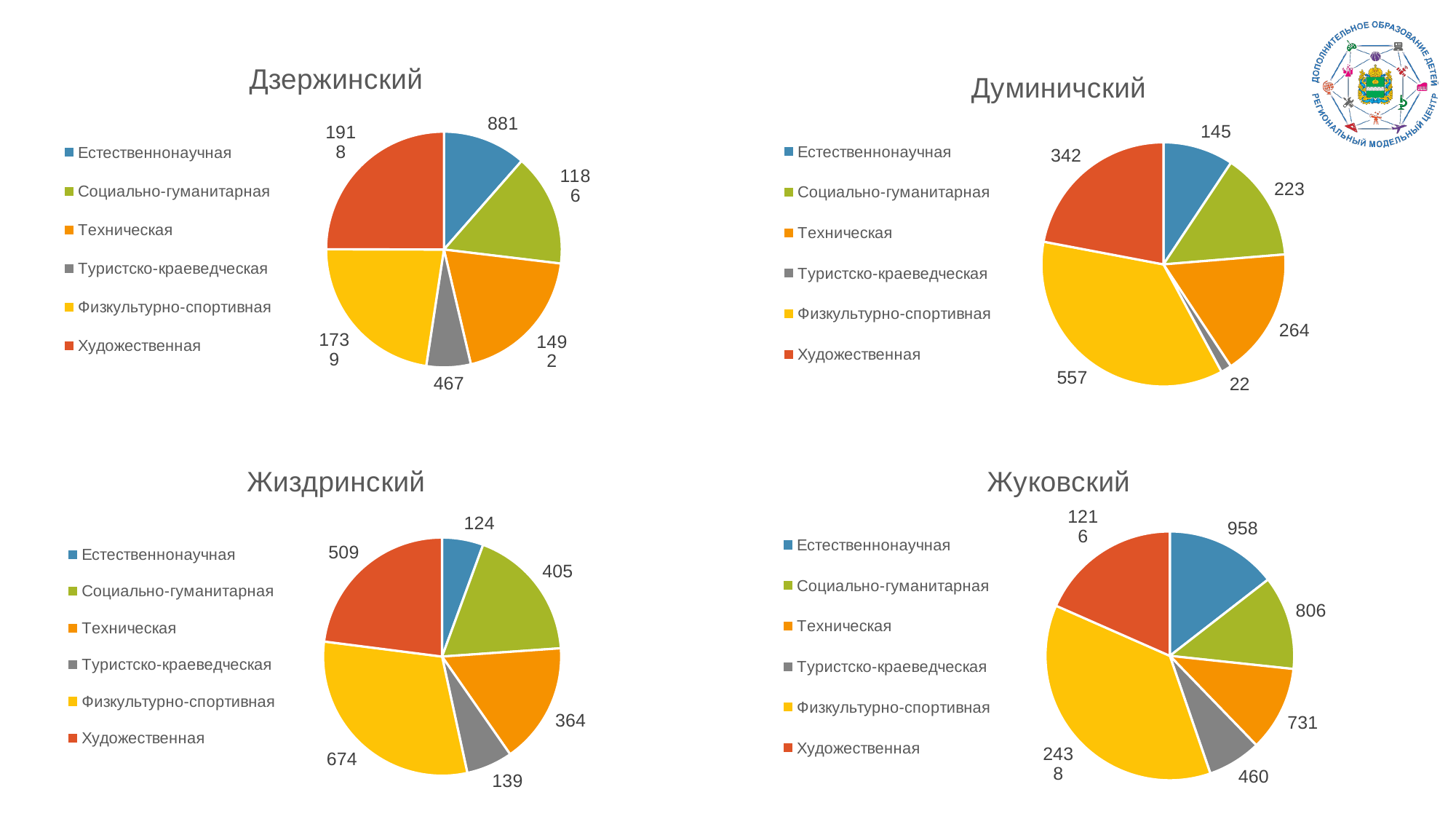
In the Жиздринский chart, what is the value for Художественная? 509 How many categories does the legend of the Дзержинский chart list? 6 What type of chart is used for Жуковский? Pie chart In the Жуковский chart, what is the difference between Социально-гуманитарная and Техническая? 75 In the Жуковский chart, what is the value for Естественнонаучная? 958 In the Думиничский chart, what is the value for Физкультурно-спортивная? 557 In the Жиздринский chart, what is the difference between Физкультурно-спортивная and Художественная? 165 In the Думиничский chart, which is larger: Техническая or Социально-гуманитарная? Техническая In the Жиздринский chart, which category has the smallest value? Естественнонаучная In the Думиничский chart, which category has the smallest value? Туристско-краеведческая In the Дзержинский chart, what is the value for Туристско-краеведческая? 467 In the Жуковский chart, which category has the largest value? Физкультурно-спортивная